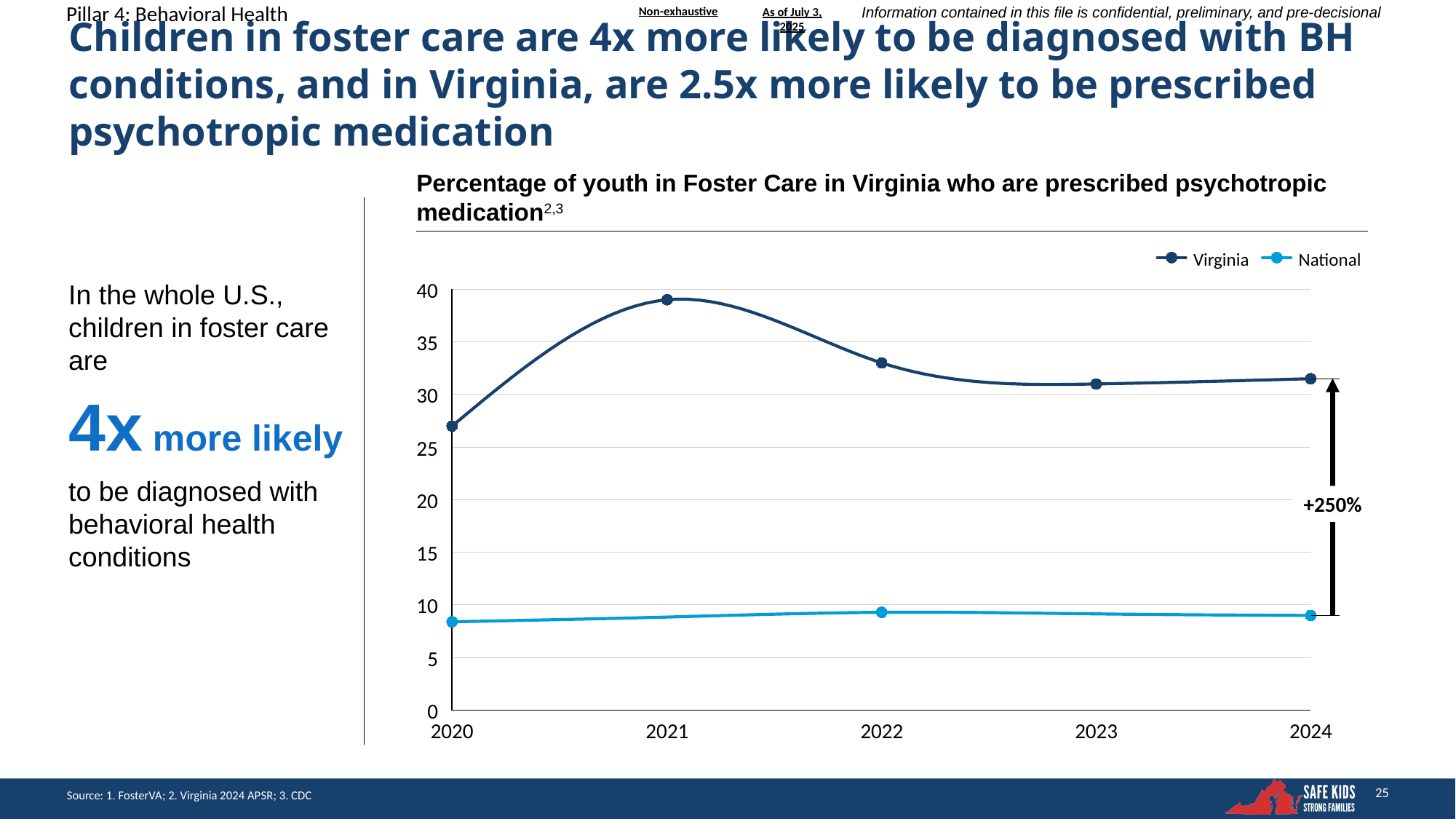
How many series does the chart legend list? 2 Does the Virginia series rise or fall from 2021 to 2023? fall Is the value for National in 2024 greater or less than 10? less Is the value for Virginia in 2023 greater or less than 30? greater How many years are shown along the x axis of the chart? 5 What kind of chart is shown on the slide? line chart Is the value for Virginia in 2020 greater or less than 25? greater In which year does the Virginia series have its lowest value? 2020 Which series has the larger value in 2022, Virginia or National? Virginia In which year does the Virginia series reach its highest value? 2021 What percentage difference is annotated by the arrow at the right of the chart between the Virginia and National lines in 2024? +250%